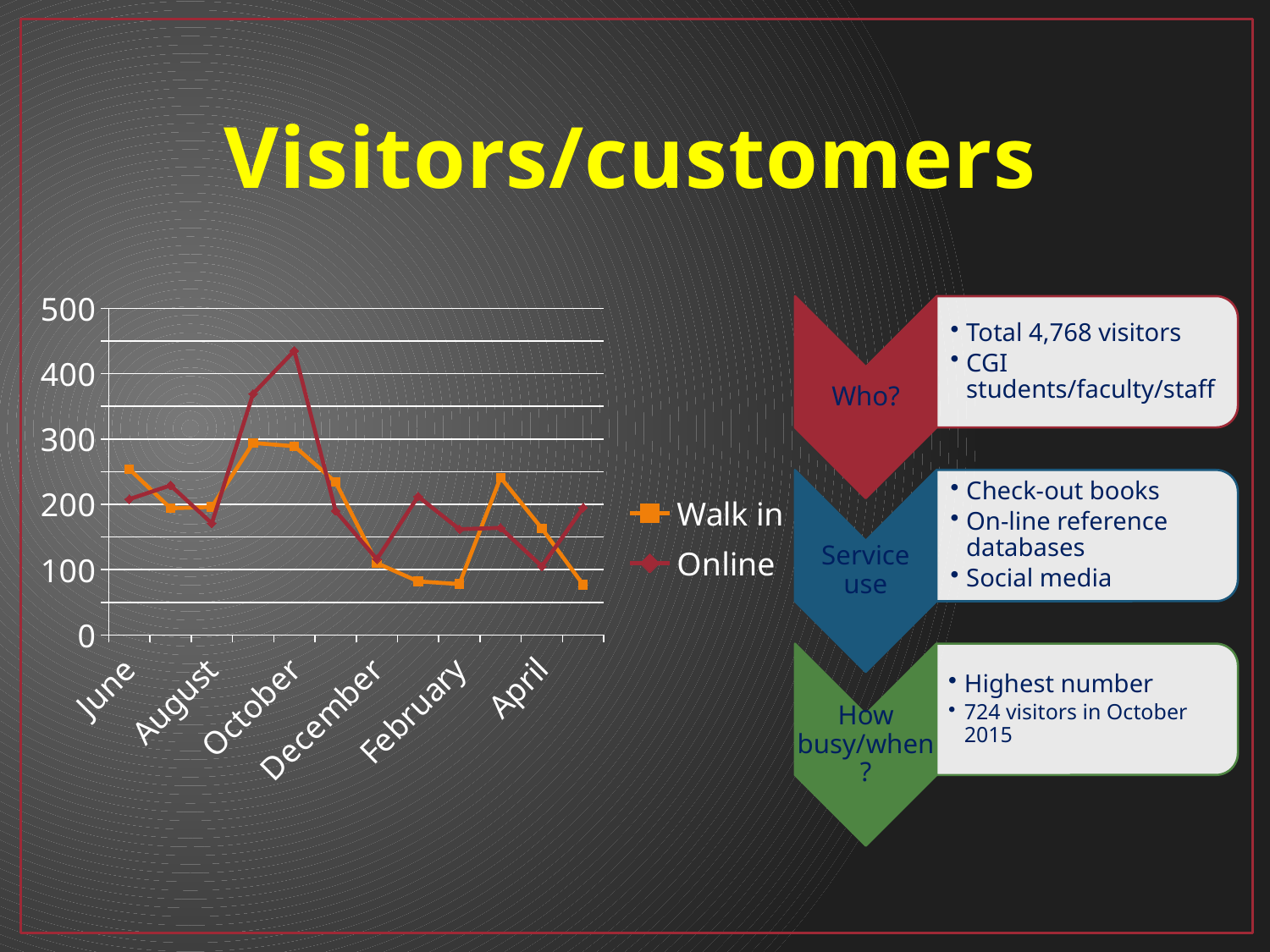
Is the Online value for August greater or less than 200? less In June, which series has the larger value, Walk in or Online? Walk in In October, which series has the larger value, Walk in or Online? Online In which month does the Online series reach its highest value? October What kind of chart is shown on the slide? line chart Does the Online series rise or fall from August to October? rise Does the Walk in series rise or fall from October to December? fall What are the two series named in the chart legend? Walk in and Online Is the Online value for October greater or less than 400? greater Is the Walk in value for June greater or less than 200? greater How many series does the chart legend list? 2